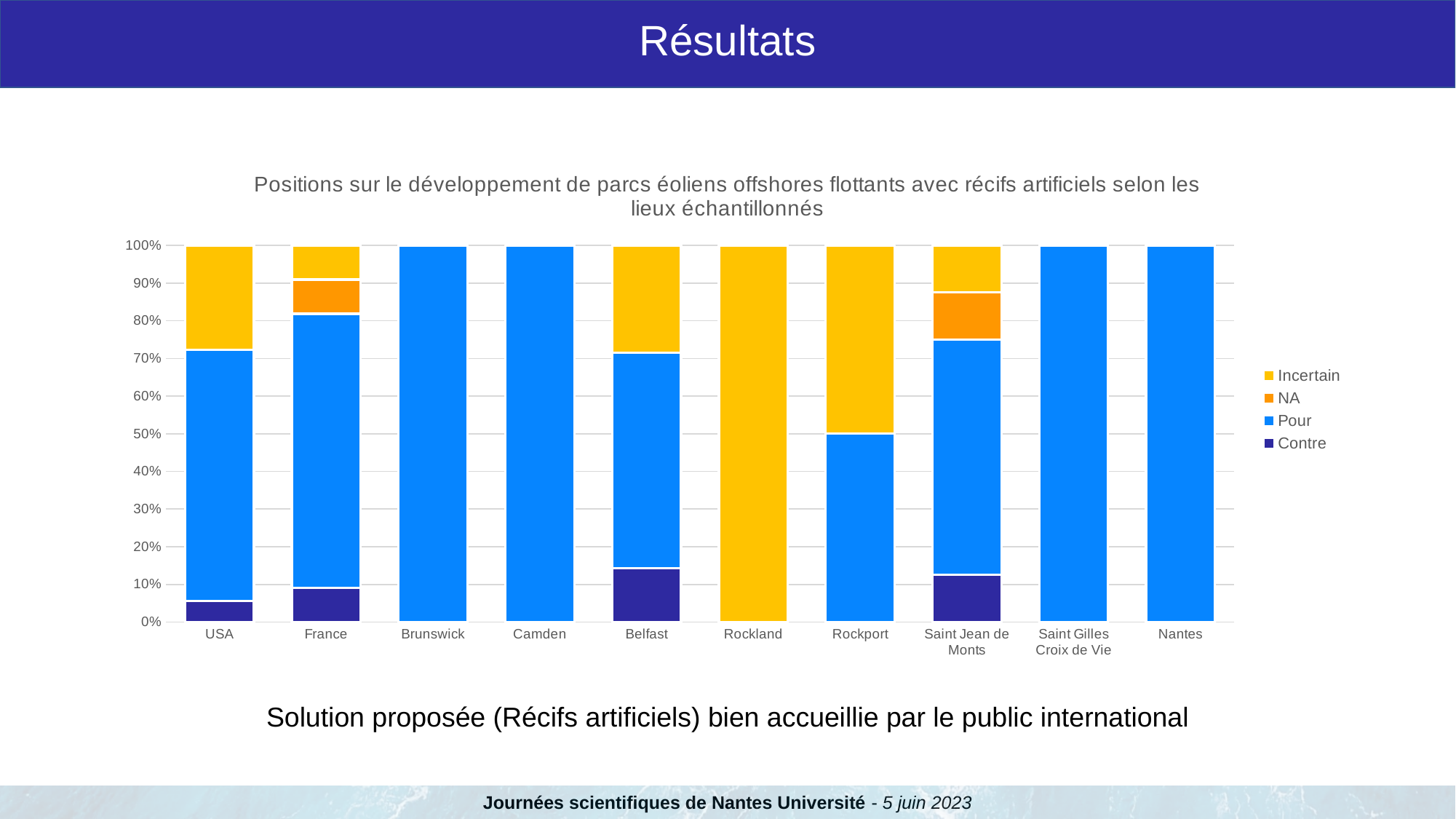
Which category has the largest Incertain share? Rockland How many series does the chart legend list? 4 Is the value for Incertain in Rockland greater or less than 90%? greater Which colour represents the NA series in the legend? Orange Is the value for Contre in Belfast greater or less than 10%? greater How many locations (categories) are shown on the x axis of the chart? 10 How many categories show an NA segment? 2 Is the value for Contre in USA greater or less than 10%? less Which is larger, the Contre share in Belfast or in USA? Belfast What kind of chart is shown on the slide? Stacked bar chart Which is larger, the Incertain share in Rockport or in USA? Rockport